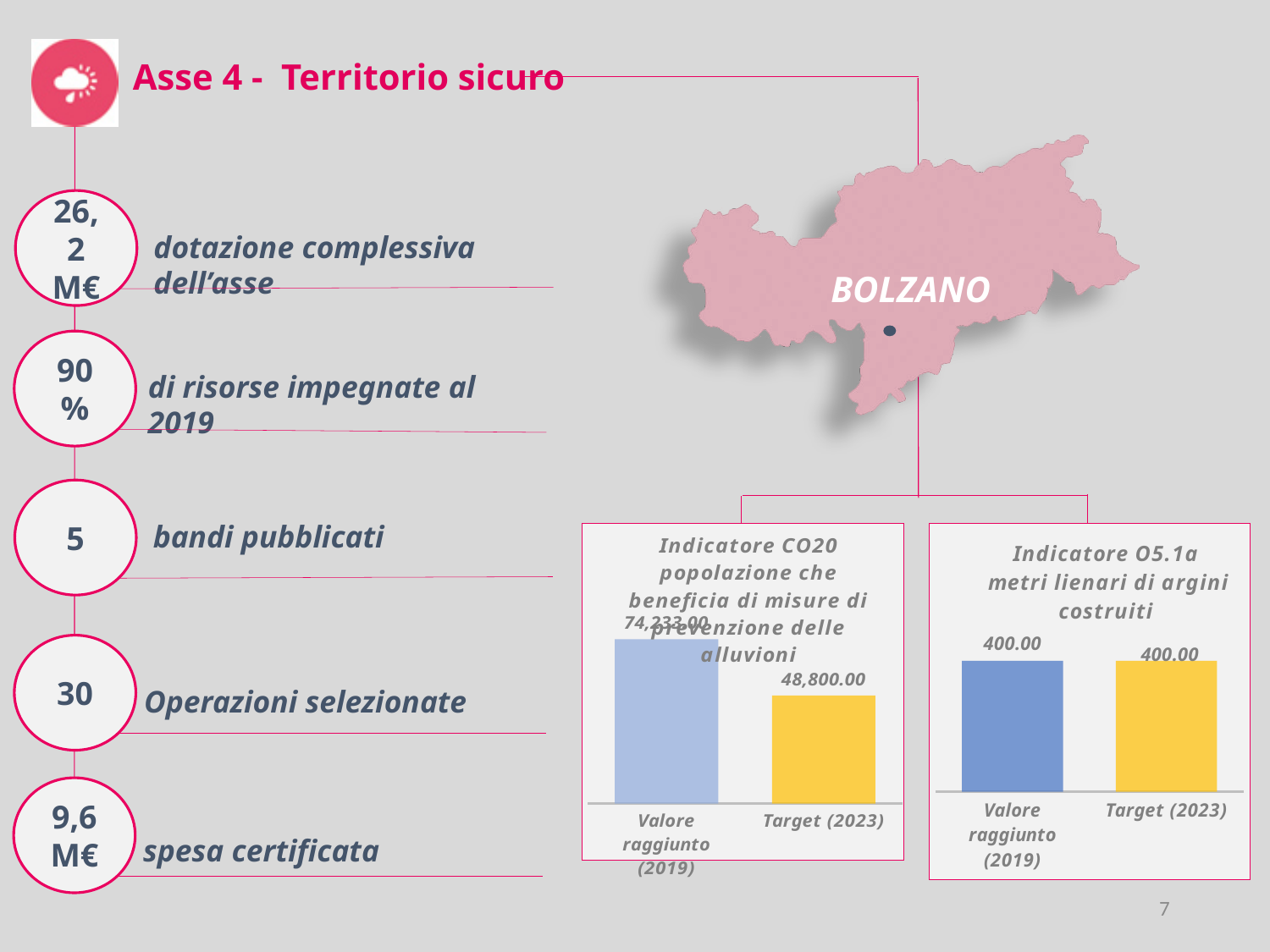
In the chart titled 'Indicatore CO20', which category has the lowest value? Target (2023) How many charts are shown on the slide? 2 What kind of chart is the chart titled 'Indicatore CO20'? bar chart In the chart titled 'Indicatore O5.1a', what colour is the Target (2023) bar? yellow What kind of chart is the chart titled 'Indicatore O5.1a'? bar chart In the chart titled 'Indicatore O5.1a', what is the difference between Target (2023) and Valore raggiunto (2019)? 0.00 In the chart titled 'Indicatore CO20', how many bars are plotted? 2 In the chart titled 'Indicatore CO20', which category has the higher value, Valore raggiunto (2019) or Target (2023)? Valore raggiunto (2019) In the chart titled 'Indicatore O5.1a', what is the value for Valore raggiunto (2019)? 400.00 In the chart titled 'Indicatore O5.1a', how many categories are shown? 2 In the chart titled 'Indicatore O5.1a', what is the value for Target (2023)? 400.00 In the chart titled 'Indicatore CO20', what is the value for Target (2023)? 48,800.00